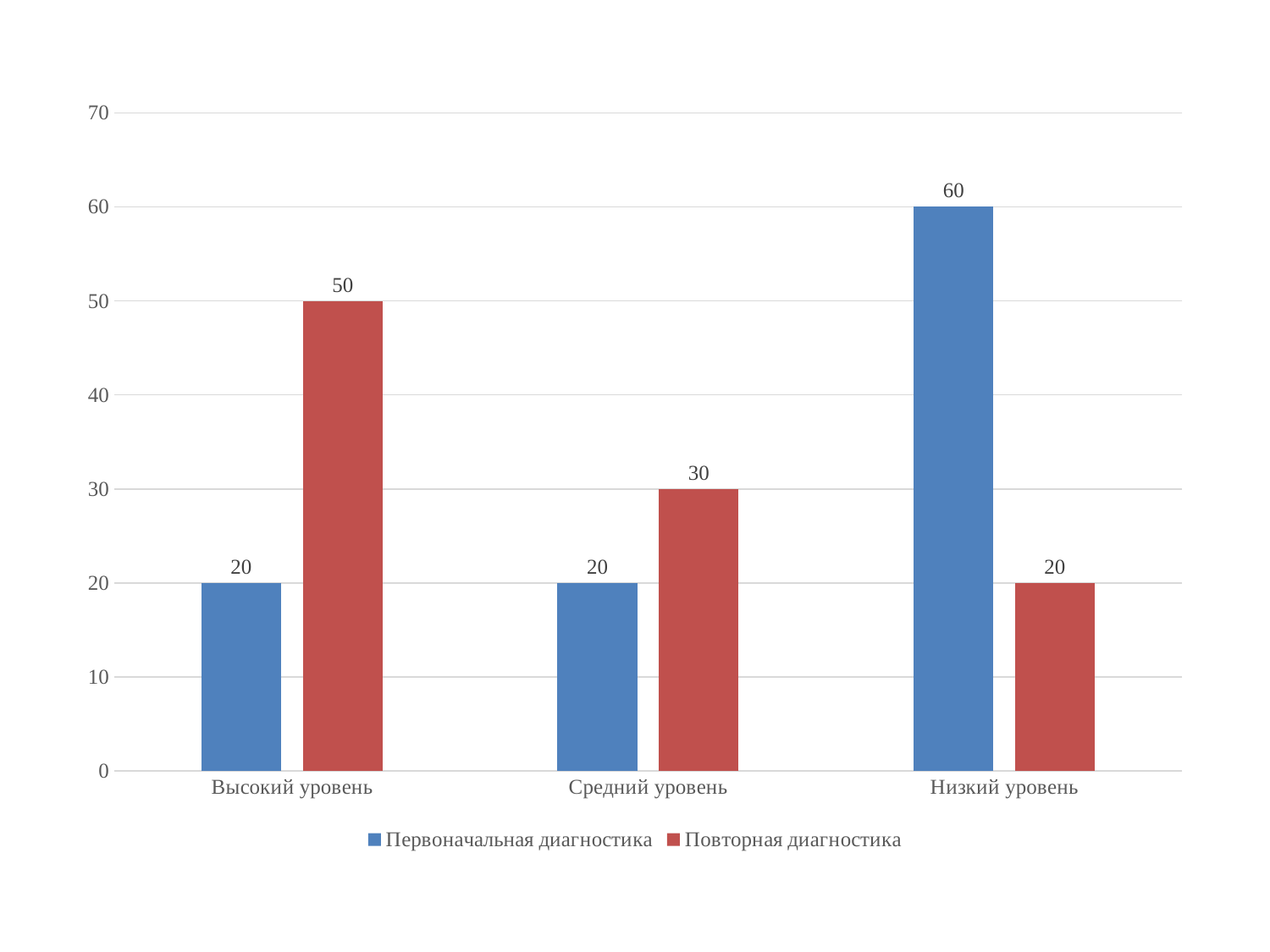
Which category has the lowest value for Повторная диагностика? Низкий уровень What is the value for Первоначальная диагностика at Высокий уровень? 20 What is the value for Первоначальная диагностика at Низкий уровень? 60 What kind of chart is shown on the slide? Bar chart Which is larger at Средний уровень: Первоначальная диагностика or Повторная диагностика? Повторная диагностика Which colour represents Повторная диагностика in the legend? Red What is the value for Повторная диагностика at Высокий уровень? 50 Which category has the highest value for Первоначальная диагностика? Низкий уровень How many categories are shown on the x axis? 3 What is the value for Повторная диагностика at Средний уровень? 30 What is the difference between Первоначальная диагностика and Повторная диагностика at Низкий уровень? 40 How many series does the legend list? 2